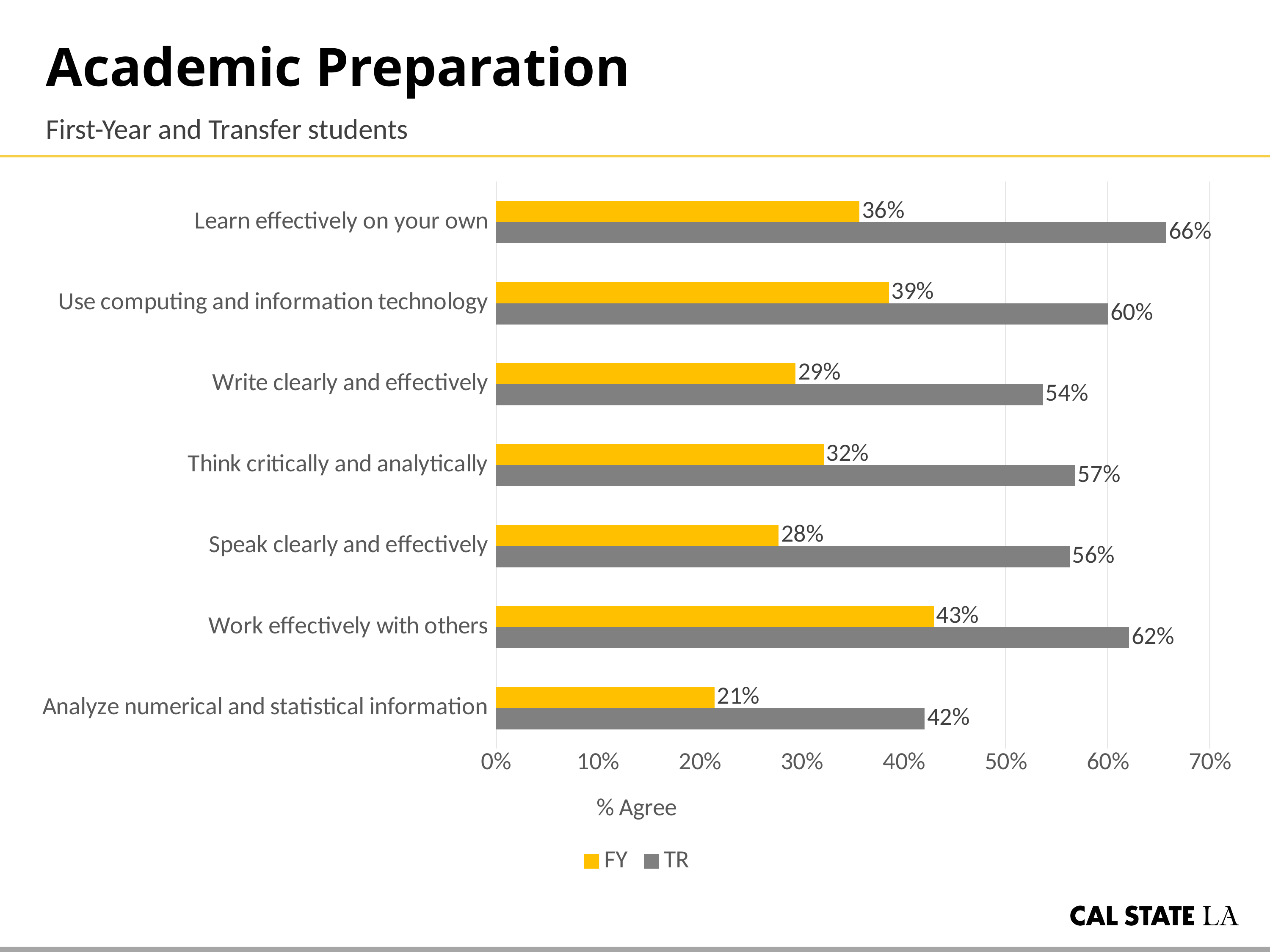
Which category has the highest FY value? Work effectively with others How many series does the legend list? 2 Which is larger for "Speak clearly and effectively": the FY value or the TR value? TR What is the FY value for "Learn effectively on your own"? 36% What kind of chart is shown on the slide? Bar chart Which category has the lowest TR value? Analyze numerical and statistical information What is the TR value for "Analyze numerical and statistical information"? 42% What is the x-axis label of the chart? % Agree What is the TR value for "Write clearly and effectively"? 54% How many categories are shown on the chart? 7 What is the difference between the TR and FY values for "Learn effectively on your own"? 30% Which colour represents the FY series? Yellow